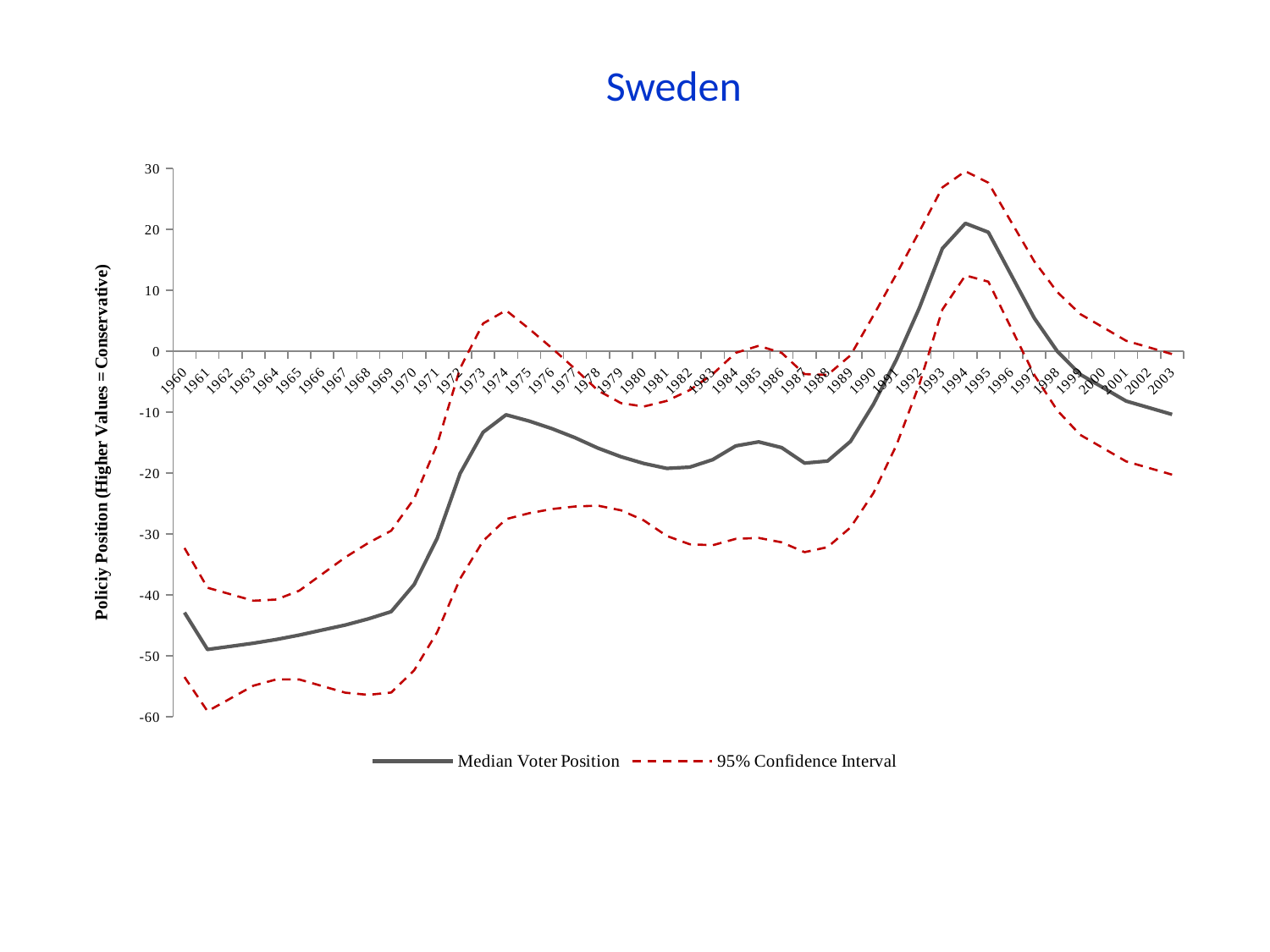
Is the Median Voter Position in 1994 greater or less than 10? greater What kind of chart is shown on the slide? Line chart How many series does the legend list? 2 Is the Median Voter Position in 1961 greater or less than -40? less Is the Median Voter Position in 2003 greater or less than 0? less What is the label of the y axis? Policiy Position (Higher Values = Conservative) Which is larger, the Median Voter Position in 1974 or in 1981? 1974 What is the title of the chart? Sweden In which year does the Median Voter Position reach its lowest value? 1961 Does the Median Voter Position rise or fall from 1995 to 2003? Fall In which year does the Median Voter Position reach its highest value? 1994 How many years are plotted along the x axis? 44